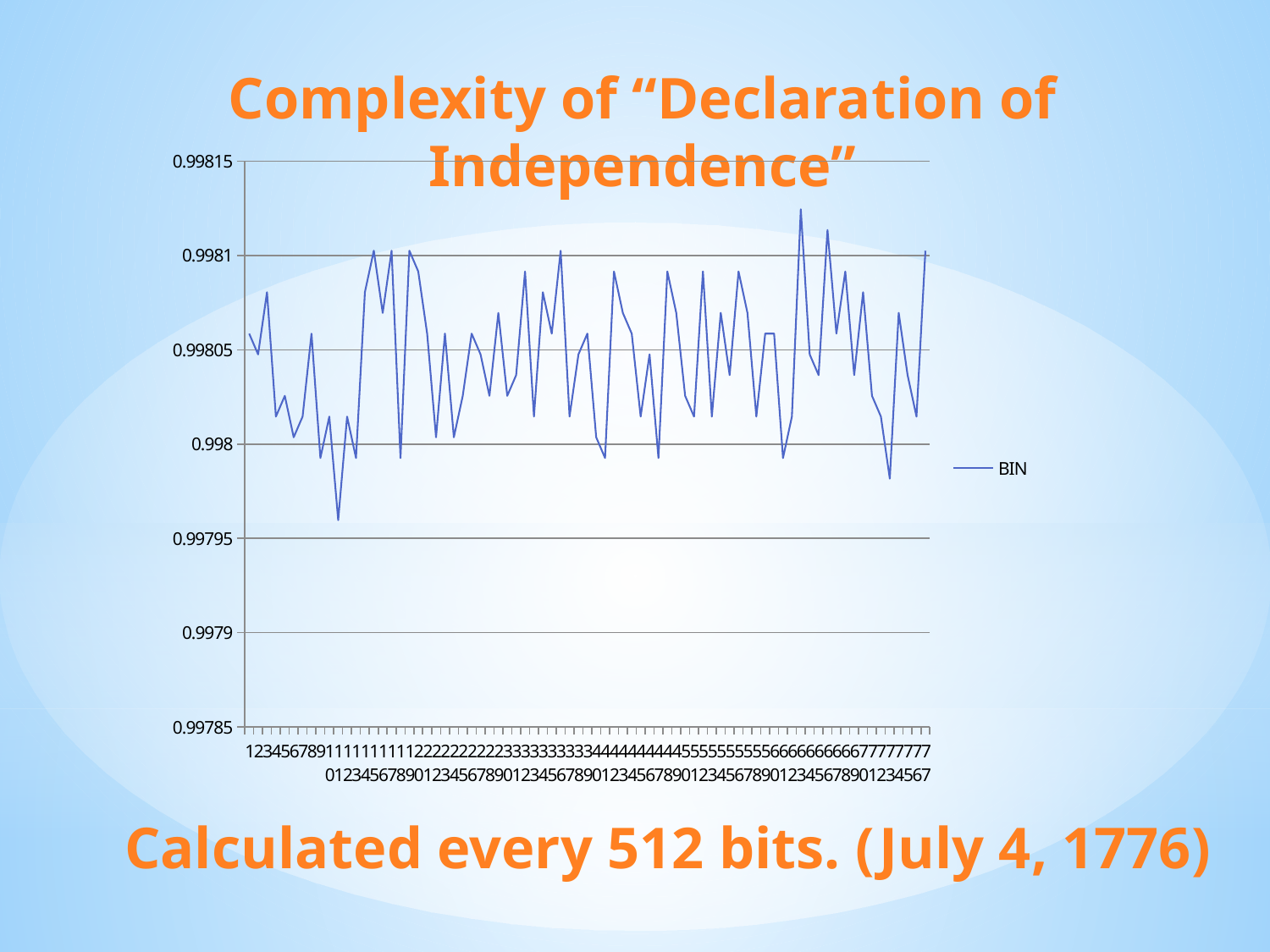
What is the title of the chart? Complexity of "Declaration of Independence" Is the lowest value of the BIN series greater or less than 0.9979? greater Is the lowest value of the BIN series greater or less than 0.998? less How many points are plotted along the x axis? 77 Is the value for the last point (77) of the BIN series greater or less than 0.99805? greater What kind of chart is shown on the slide? line chart How many series does the legend list? 1 What is the name of the series shown in the legend? BIN